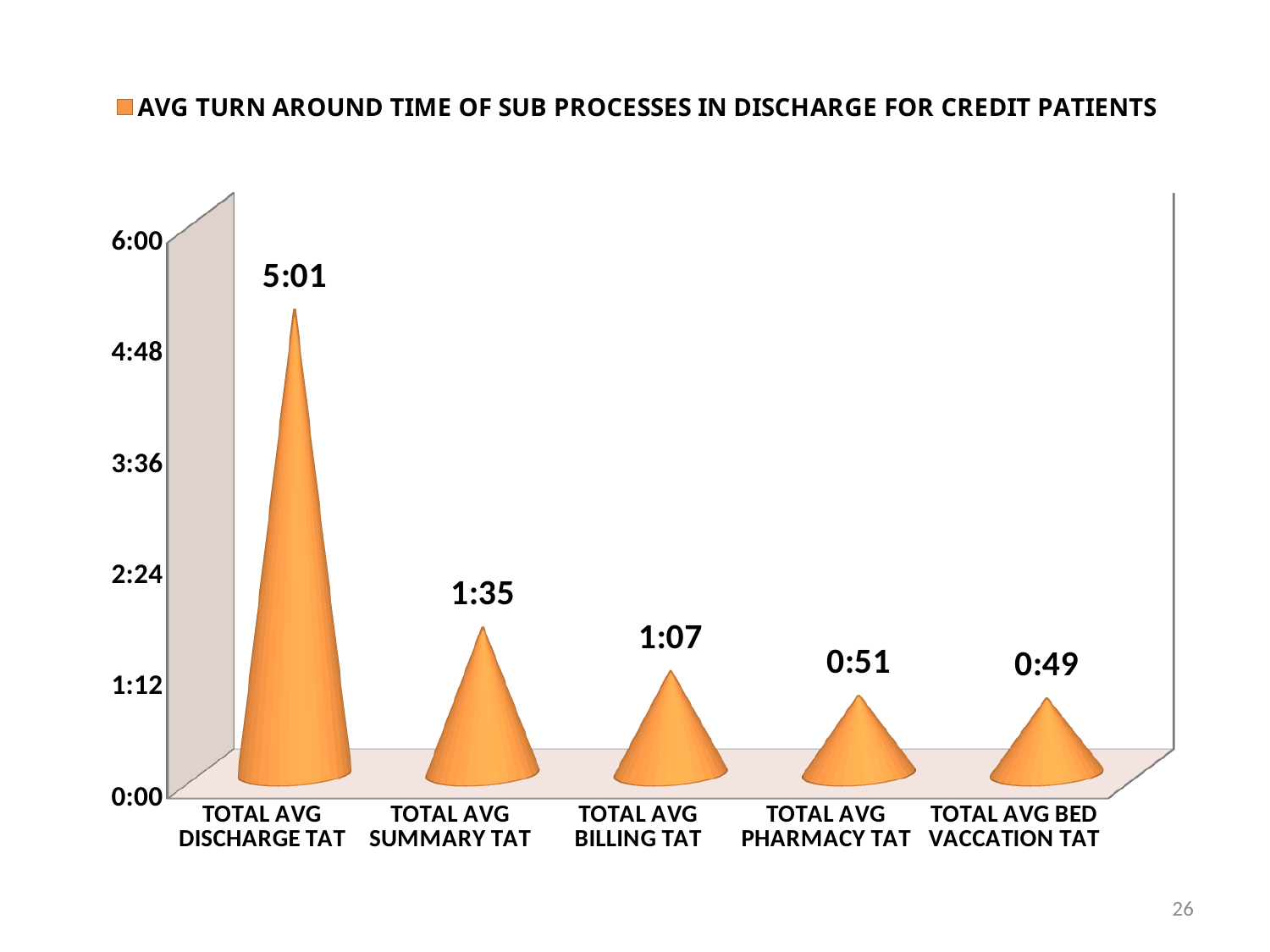
What is the value for TOTAL AVG BED VACCATION TAT? 0:49 Do the values rise or fall from left to right along the x axis? fall Which is larger, TOTAL AVG SUMMARY TAT or TOTAL AVG PHARMACY TAT? TOTAL AVG SUMMARY TAT Which category has the highest value? TOTAL AVG DISCHARGE TAT What is the difference between TOTAL AVG SUMMARY TAT and TOTAL AVG BILLING TAT? 0:28 What is the value for TOTAL AVG DISCHARGE TAT? 5:01 What is the value for TOTAL AVG PHARMACY TAT? 0:51 What is the value for TOTAL AVG BILLING TAT? 1:07 Which category has the lowest value? TOTAL AVG BED VACCATION TAT How many categories are shown on the x axis? 5 What is the title of the chart shown in the legend? AVG TURN AROUND TIME OF SUB PROCESSES IN DISCHARGE FOR CREDIT PATIENTS What is the value for TOTAL AVG SUMMARY TAT? 1:35